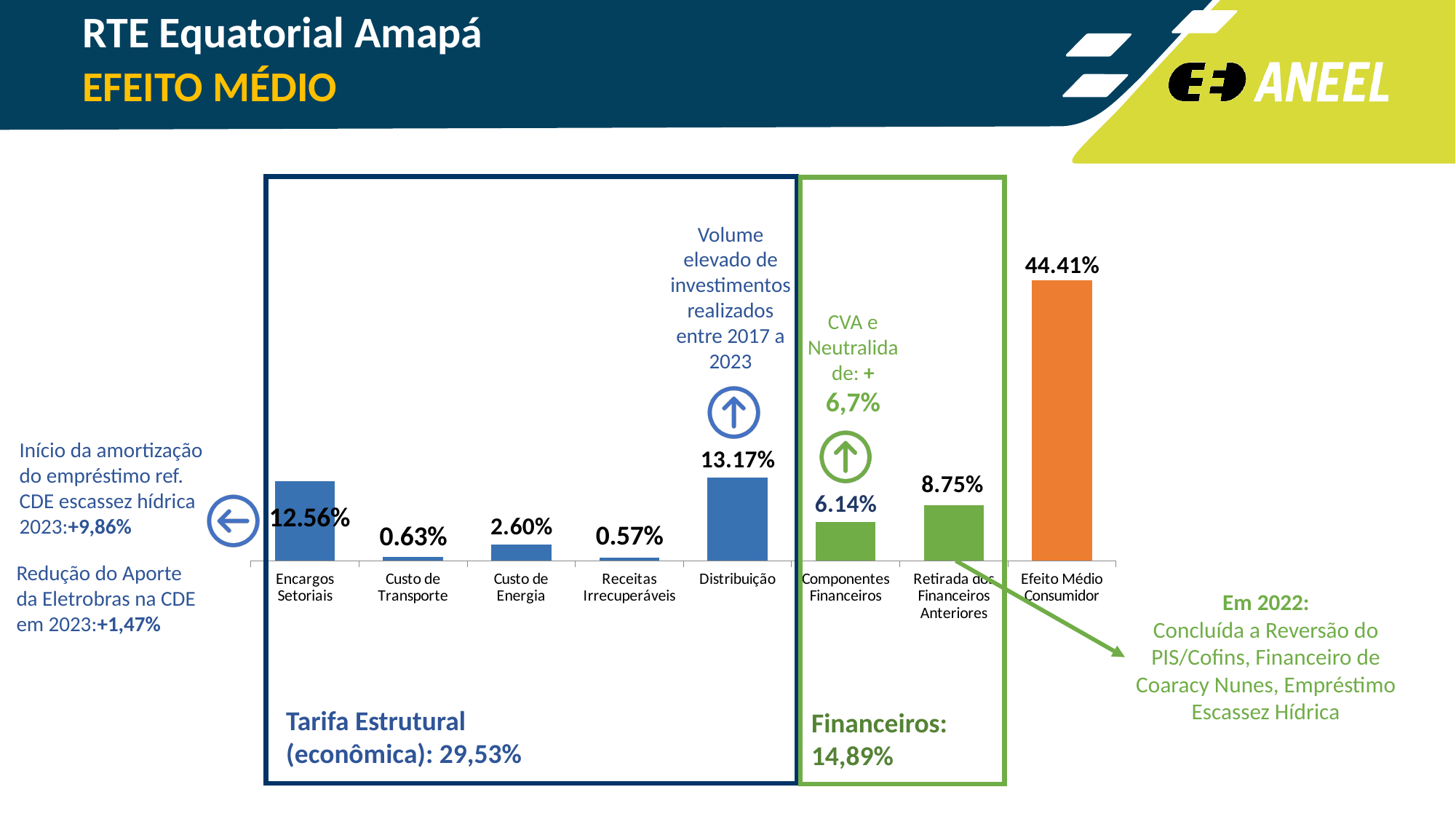
What is the value for Encargos Setoriais? 12.56% Which category has the lowest value? Receitas Irrecuperáveis Which is larger, the value for Custo de Transporte or the value for Custo de Energia? Custo de Energia What is the difference between the values for Distribuição and Encargos Setoriais? 0.61 percentage points How many categories are shown on the x axis? 8 What is the difference between the values for Retirada dos Financeiros Anteriores and Componentes Financeiros? 2.61 percentage points What kind of chart is shown on the slide? Bar chart Which category has the highest value? Efeito Médio Consumidor What is the value for Retirada dos Financeiros Anteriores? 8.75% What is the value for Distribuição? 13.17% What colour is the bar for Efeito Médio Consumidor? Orange What is the value for Custo de Energia? 2.60%